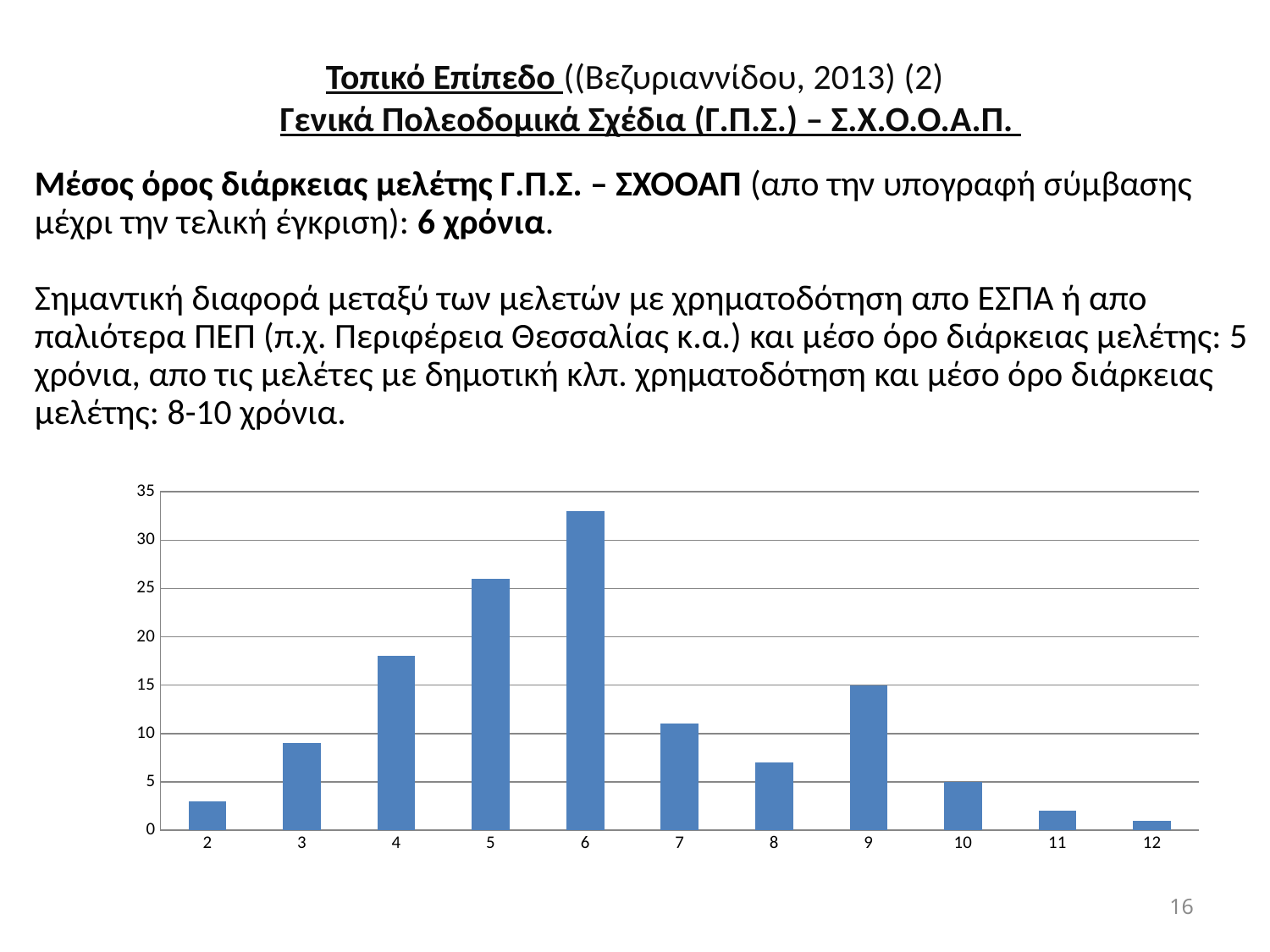
Is the value for category 6 greater or less than 30? greater Do the values rise or fall from category 6 to category 8? fall Which is larger, the value for category 5 or the value for category 9? 5 How many categories are shown on the x axis of the chart? 11 Which category has the highest bar in the chart? 6 Is the value for category 4 greater or less than 20? less Is the value for category 5 greater or less than 25? greater What kind of chart is shown on the slide? bar chart Which is larger, the value for category 4 or the value for category 7? 4 Which category has the lowest bar in the chart? 12